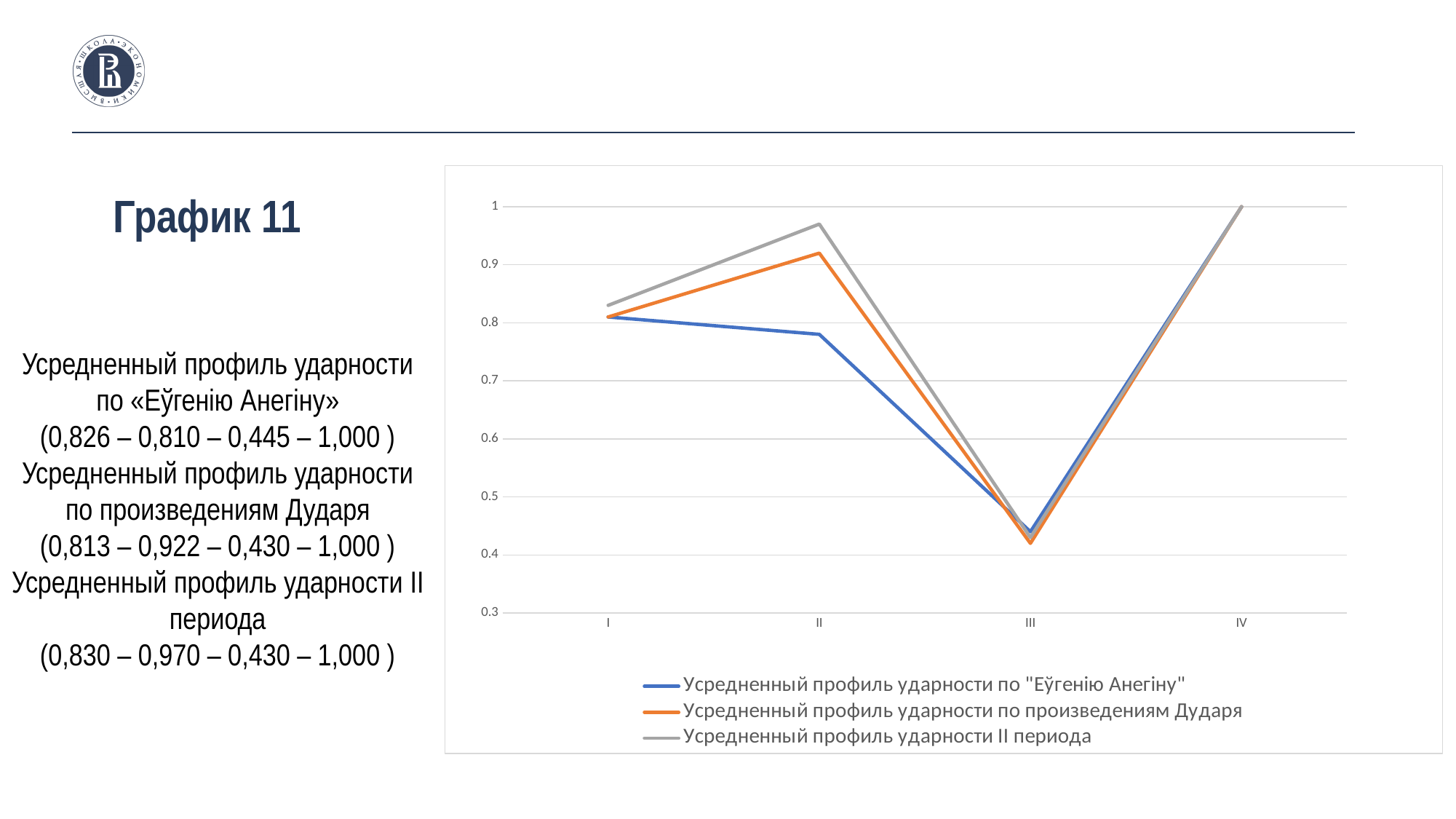
What kind of chart is shown on the slide? line chart Do the values of all three series rise or fall from category II to category III? fall At which category does the series "Усредненный профиль ударности по произведениям Дударя" have its lowest value? III At which category does the series "Усредненный профиль ударности II периода" reach its highest value? IV At category II, which series is higher: "Усредненный профиль ударности II периода" or "Усредненный профиль ударности по произведениям Дударя"? Усредненный профиль ударности II периода What is the value of the series "Усредненный профиль ударности по произведениям Дударя" at category II? 0,922 What colour is the line for "Усредненный профиль ударности по произведениям Дударя" in the chart? orange Is the value of the series "Усредненный профиль ударности по "Еўгенію Анегіну"" at category II greater or less than 0.8? less What is the value of the series "Усредненный профиль ударности II периода" at category II? 0,970 How many categories are shown along the x axis of the chart? 4 How many series does the chart legend list? 3 What is the difference between the values of "Усредненный профиль ударности II периода" and "Усредненный профиль ударности по произведениям Дударя" at category II? 0,048